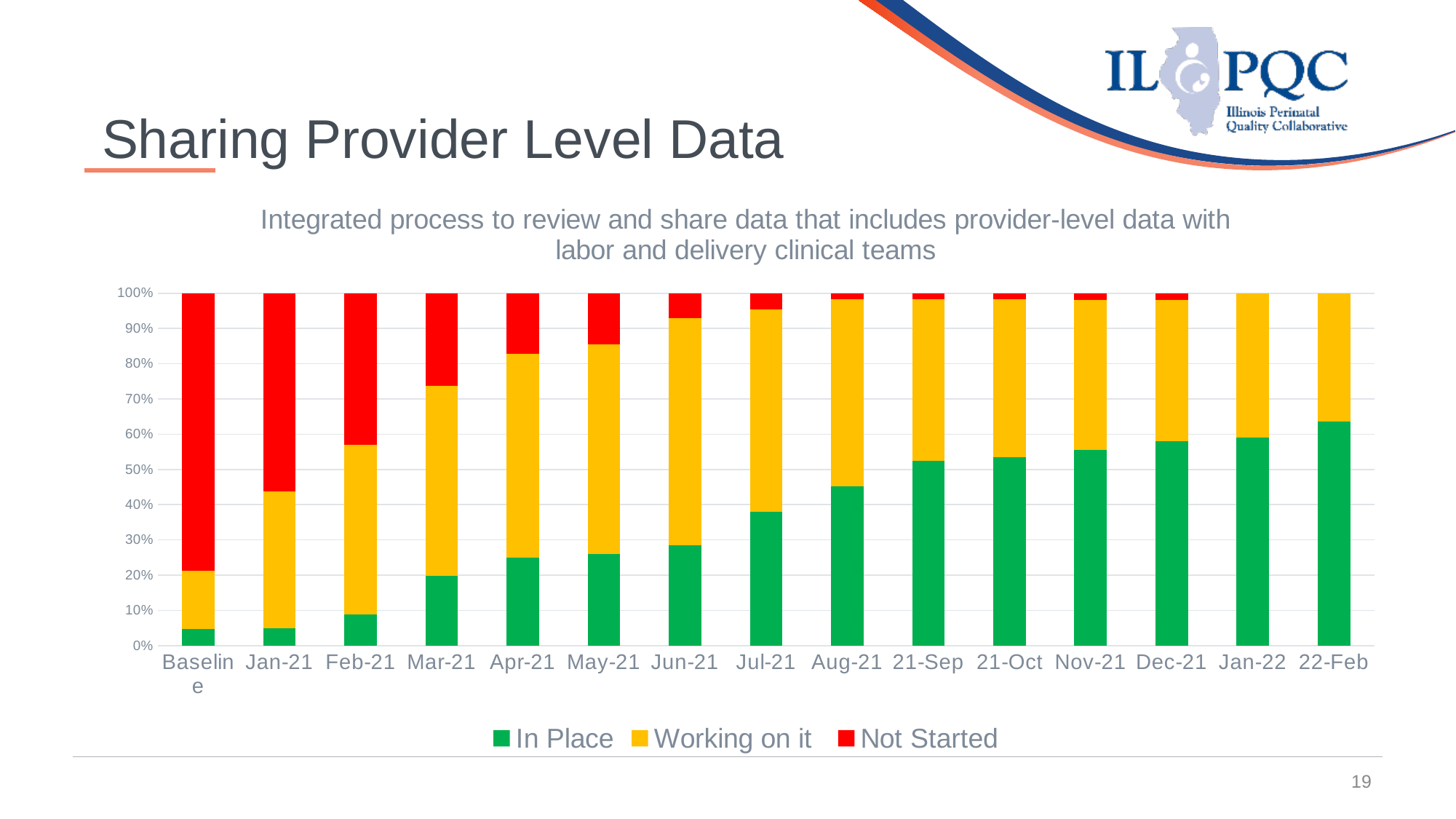
Which category has the highest 'Not Started' value? Baseline Which legend entry is shown in red? Not Started What kind of chart is shown on the slide? Stacked bar chart Is the 'In Place' value for Baseline greater or less than 10%? less How many series does the legend list? 3 Is the 'Not Started' value for Baseline greater or less than 70%? greater Is the 'In Place' value for Jul-21 greater or less than 40%? less Which category has the highest 'In Place' value? 22-Feb Does the 'In Place' share rise or fall from Baseline to 22-Feb? rise How many time-period categories are plotted along the x axis? 15 Which has the larger 'In Place' value, Mar-21 or Dec-21? Dec-21